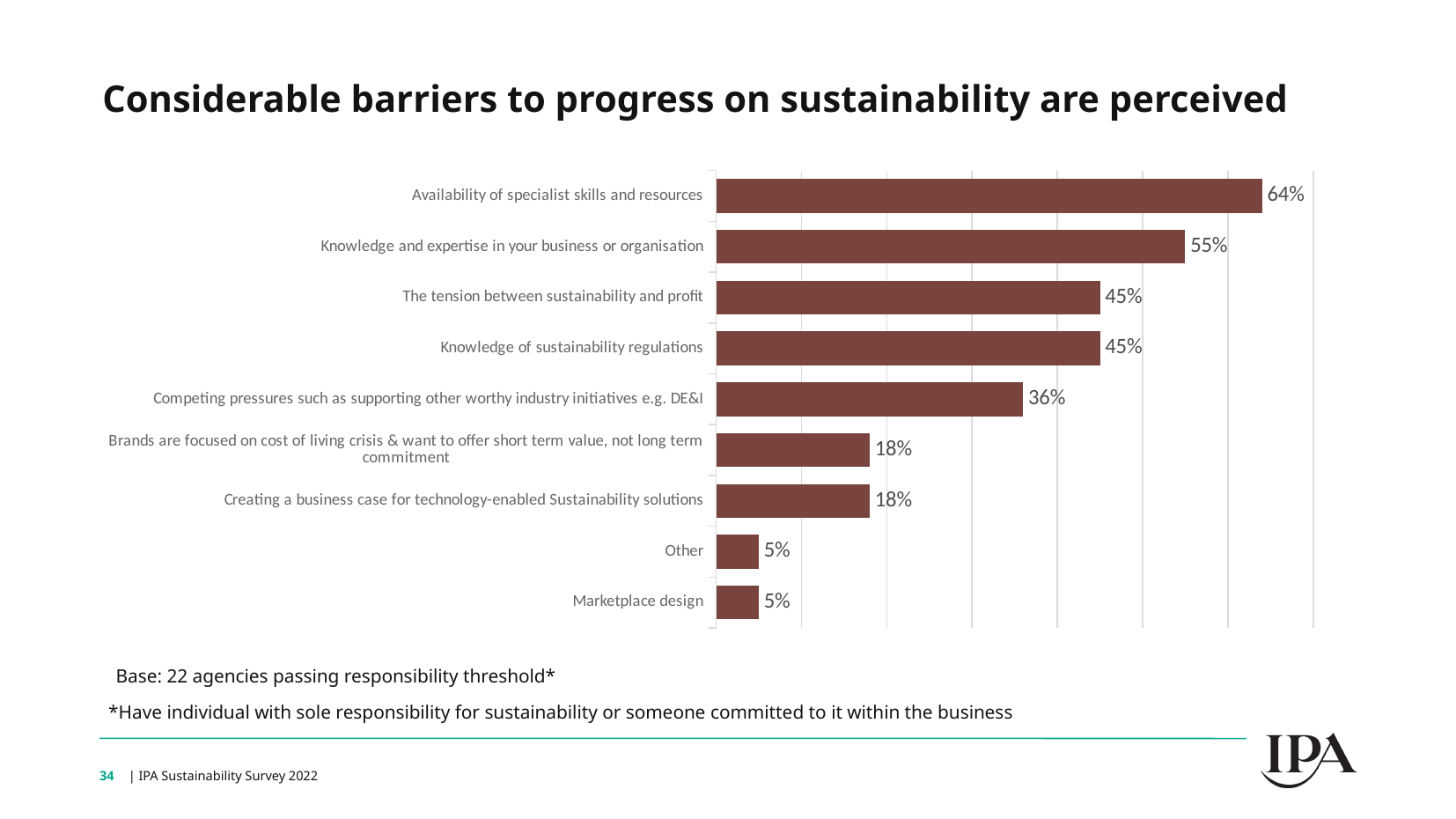
What is the difference between 'The tension between sustainability and profit' and 'Creating a business case for technology-enabled Sustainability solutions'? 27% What is the difference between the values for 'Availability of specialist skills and resources' and 'Knowledge and expertise in your business or organisation'? 9% What value is shown for 'Marketplace design'? 5% What value is shown for 'Knowledge and expertise in your business or organisation'? 55% What kind of chart is shown on the slide? Bar chart Which barrier has the highest percentage? Availability of specialist skills and resources What percentage is shown for 'Availability of specialist skills and resources'? 64% Which is larger: the value for 'Knowledge of sustainability regulations' or the value for 'Competing pressures such as supporting other worthy industry initiatives e.g. DE&I'? Knowledge of sustainability regulations What is the title of the slide containing the chart? Considerable barriers to progress on sustainability are perceived How many agencies form the base for the chart? 22 How many barrier categories are plotted in the chart? 9 What percentage is shown for 'Competing pressures such as supporting other worthy industry initiatives e.g. DE&I'? 36%